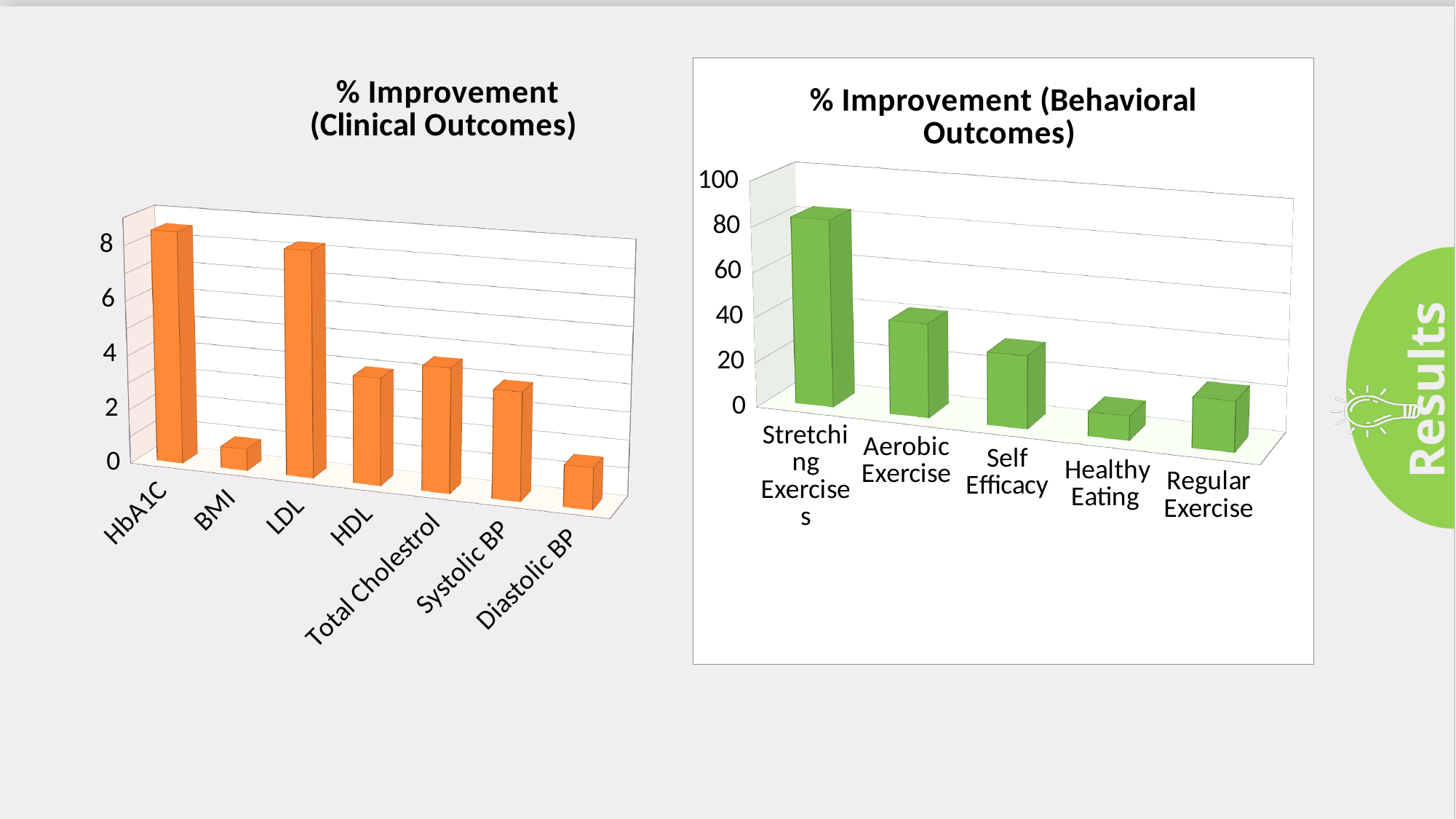
What colour are the bars in the '% Improvement (Behavioral Outcomes)' chart? green How many categories are shown in the '% Improvement (Clinical Outcomes)' chart? 7 In the '% Improvement (Behavioral Outcomes)' chart, which category has the highest value? Stretching Exercises What type of chart is the '% Improvement (Clinical Outcomes)' chart? bar chart In the '% Improvement (Behavioral Outcomes)' chart, is the value for Healthy Eating greater or less than 20? less In the '% Improvement (Clinical Outcomes)' chart, which is larger, the value for LDL or the value for HDL? LDL In the '% Improvement (Behavioral Outcomes)' chart, is the value for Self Efficacy greater or less than 40? less In the '% Improvement (Clinical Outcomes)' chart, is the value for BMI greater or less than 2? less How many categories are shown in the '% Improvement (Behavioral Outcomes)' chart? 5 In the '% Improvement (Behavioral Outcomes)' chart, which is larger, the value for Aerobic Exercise or the value for Healthy Eating? Aerobic Exercise